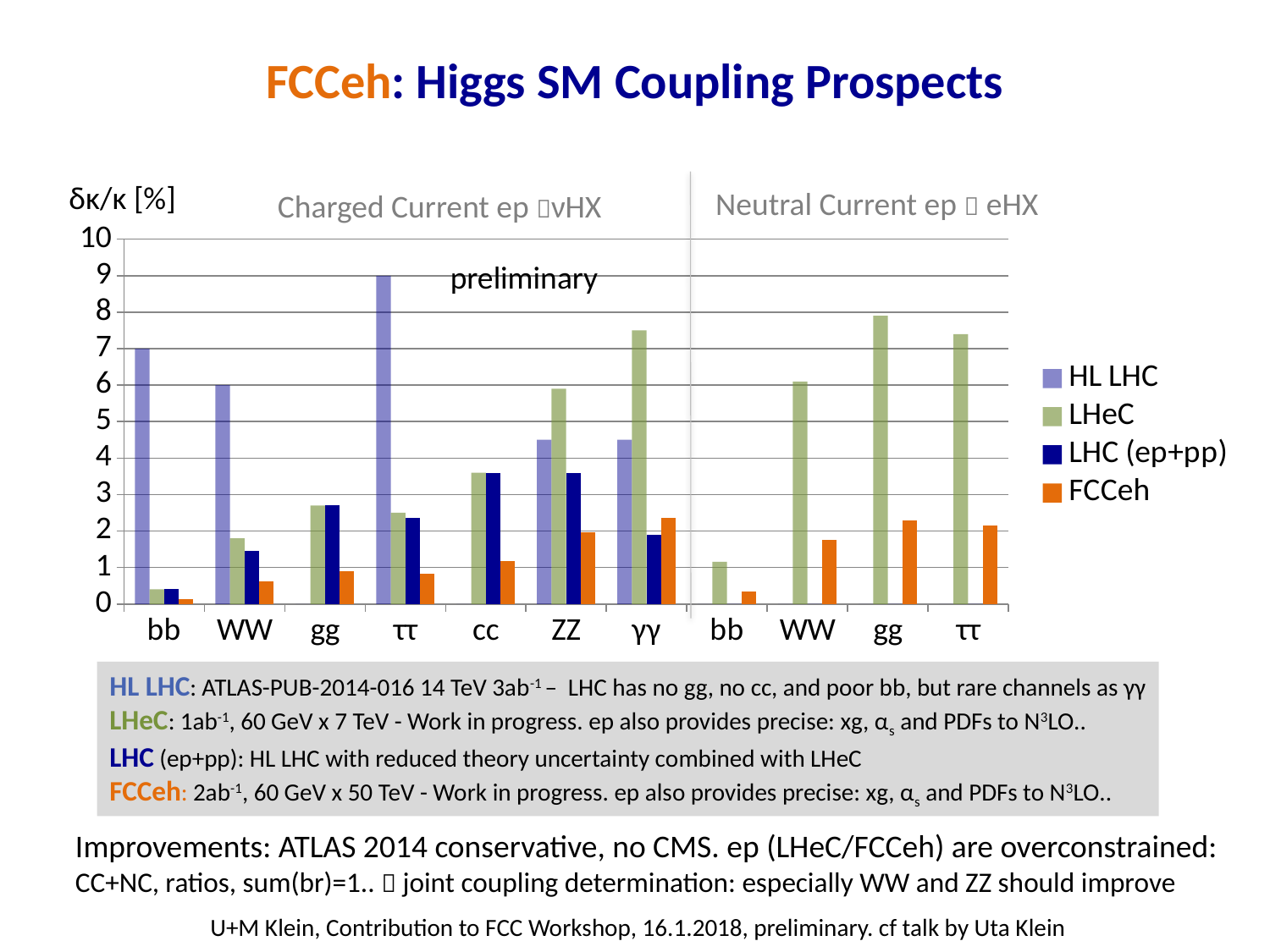
How many series does the legend list? 4 Is the HL LHC value for ZZ greater or less than 5? less Is the LHeC value for gg in the Neutral Current section greater or less than 7? greater What is the HL LHC value for ττ in the Charged Current section? 9 For which category is the HL LHC value highest? ττ What kind of chart is shown on the slide? bar chart How many categories are shown along the x axis? 11 What is the label on the y axis? δκ/κ [%] For bb in the Charged Current section, which is larger: HL LHC or LHeC? HL LHC Is the LHeC value for bb in the Charged Current section greater or less than 1? less What is the HL LHC value for bb in the Charged Current section? 7